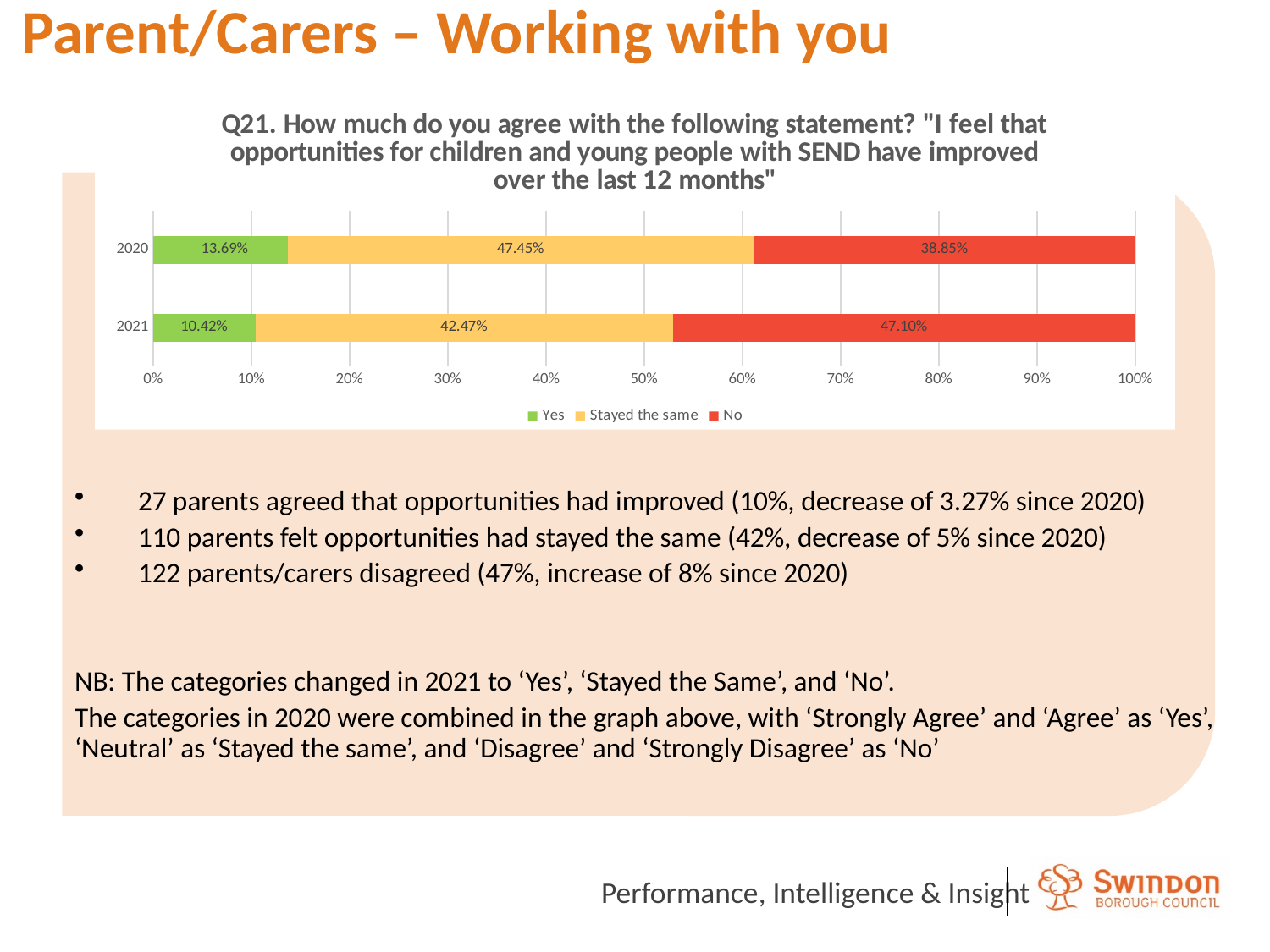
What is the value for "Yes" in 2020? 13.69% What is the value for "No" in 2021? 47.10% What is the value for "Stayed the same" in 2021? 42.47% Which series has the largest value in 2020? Stayed the same What kind of chart is shown on the slide? Stacked bar chart What is the difference between the "No" values for 2021 and 2020? 8.25% How many series does the legend list? 3 What is the difference between the "Stayed the same" values for 2020 and 2021? 4.98% Which series has the smallest value in 2021? Yes Which year has the higher "Yes" value? 2020 What is the value for "No" in 2020? 38.85% Which year has the higher "No" value? 2021